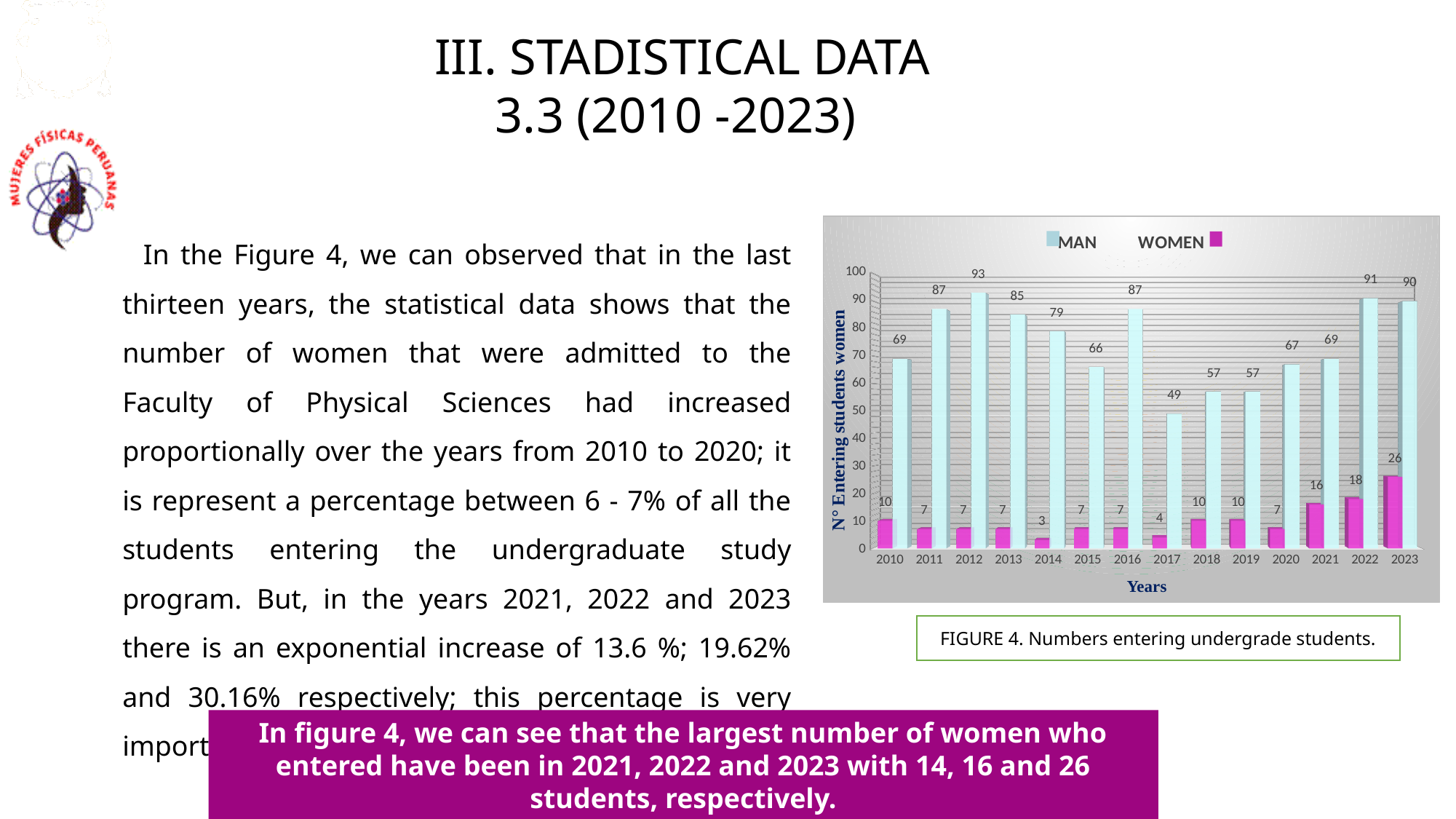
What is the value for MAN in 2017? 49 In which year is the MAN value highest? 2012 Which is larger, the MAN value in 2011 or the MAN value in 2013? 2011 How many series does the legend list? 2 In which year is the WOMEN value lowest? 2014 What is the difference between the MAN and WOMEN values in 2023? 64 What type of chart is shown on the slide? bar chart Do the WOMEN values rise or fall from 2020 to 2023? rise What is the value for MAN in 2012? 93 What is the label of the y axis of the chart? N° Entering students women What is the value for WOMEN in 2023? 26 How many years are shown on the x axis of the chart? 14